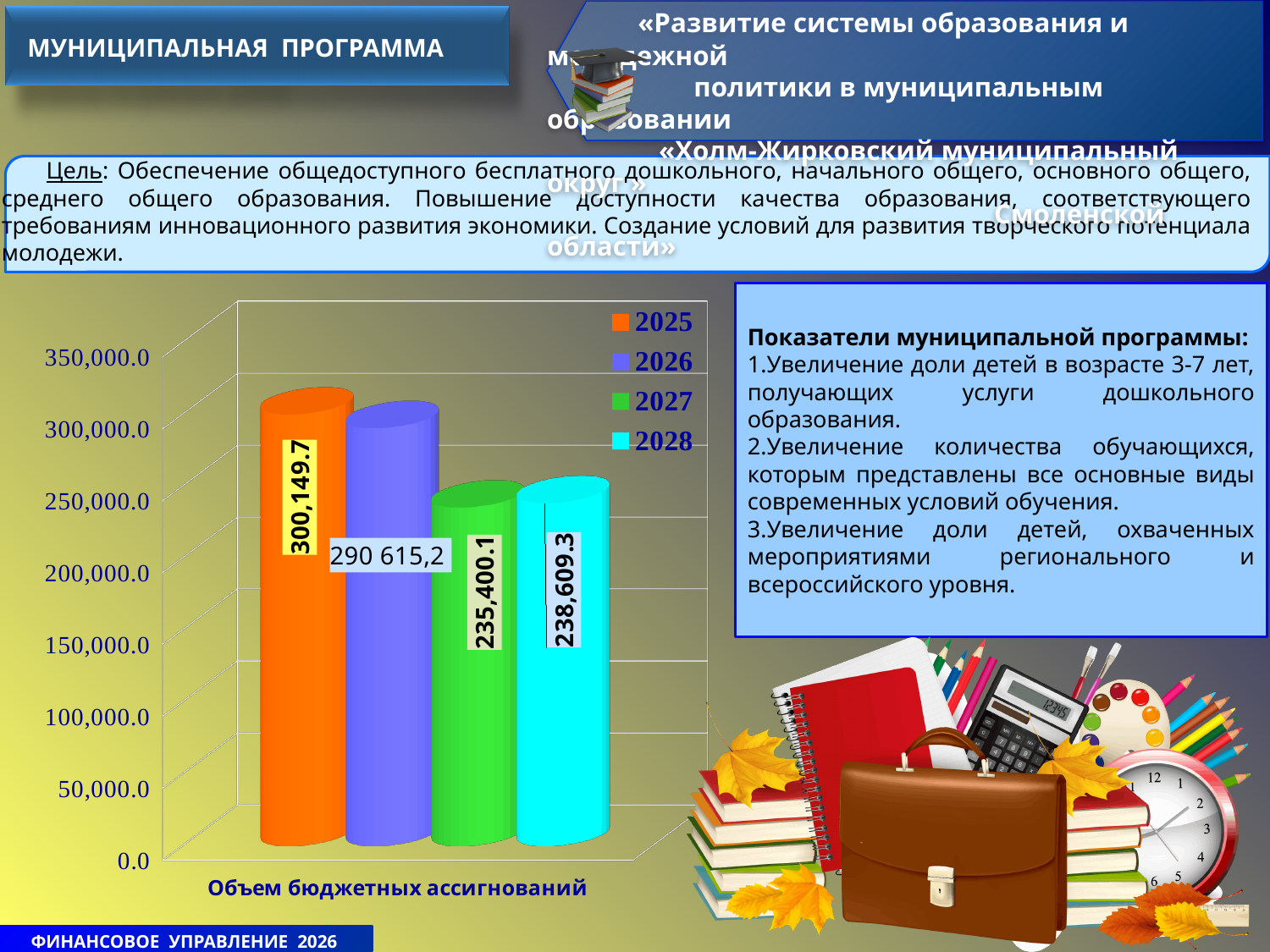
What is the value for 2028 in the chart? 238,609.3 What is the value for 2025 in the chart? 300,149.7 What is the value for 2026 in the chart? 290 615,2 What is the difference between the values for 2025 and 2026? 9,534.5 How many series does the legend list? 4 Which year has the highest value in the chart? 2025 What kind of chart is shown on the slide? bar chart Which year has the lowest value in the chart? 2027 Is the value for 2025 greater or less than 250,000.0? greater What is the category label shown under the bars? Объем бюджетных ассигнований What is the value for 2027 in the chart? 235,400.1 Which is larger, the value for 2027 or the value for 2028? 2028